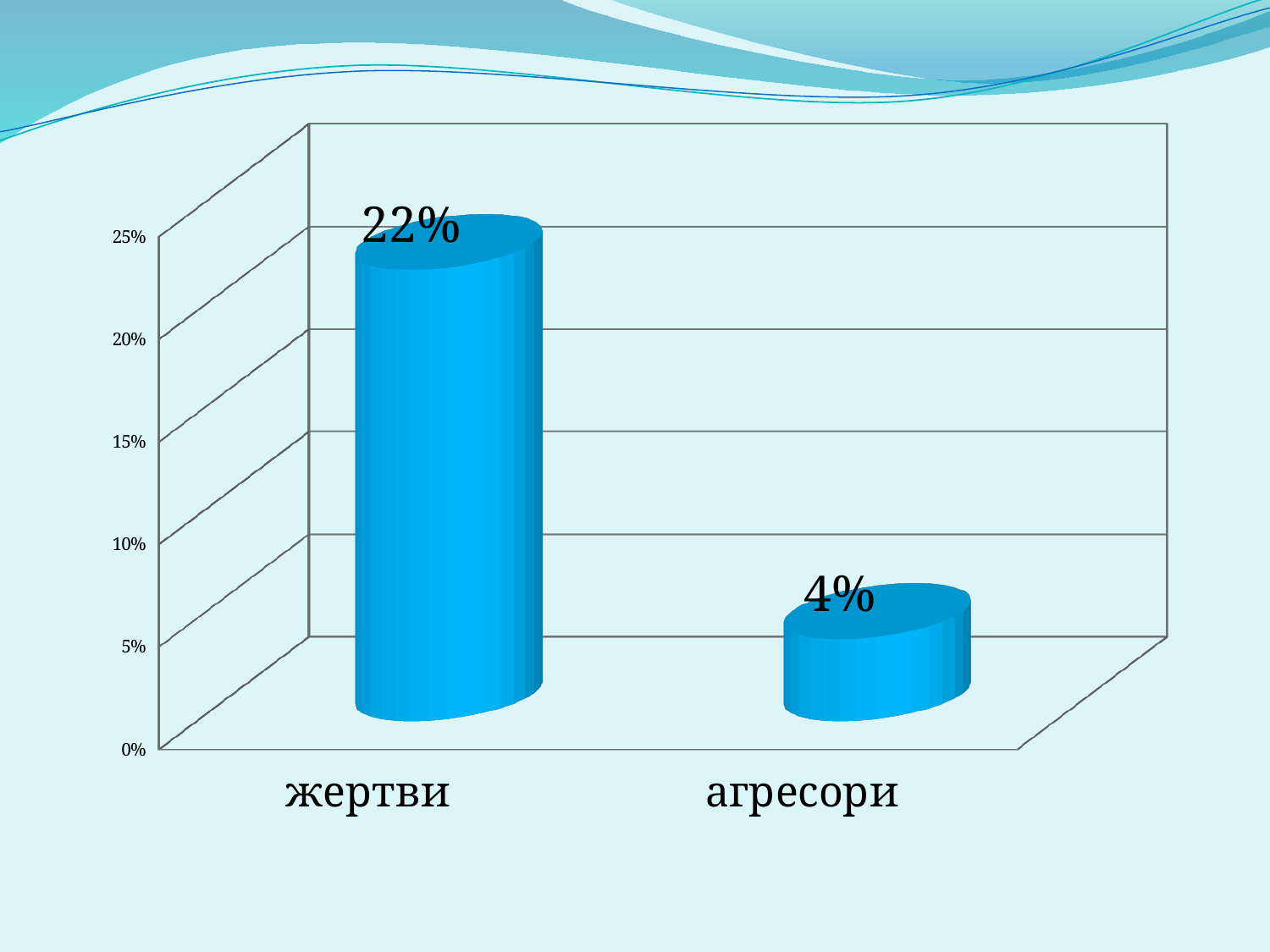
What is the value for агресори? 4% What is the value for жертви? 22% How many categories are shown on the chart? 2 What is the difference between the values for жертви and агресори? 18% Which category has the lowest value? агресори Which category has the highest value? жертви Is the value for жертви greater or less than 20%? greater Is the value for агресори greater or less than 5%? less Which is larger, the value for жертви or the value for агресори? жертви What is the highest value shown on the vertical axis? 25% What colour are the bars on the chart? blue What kind of chart is shown on the slide? bar chart